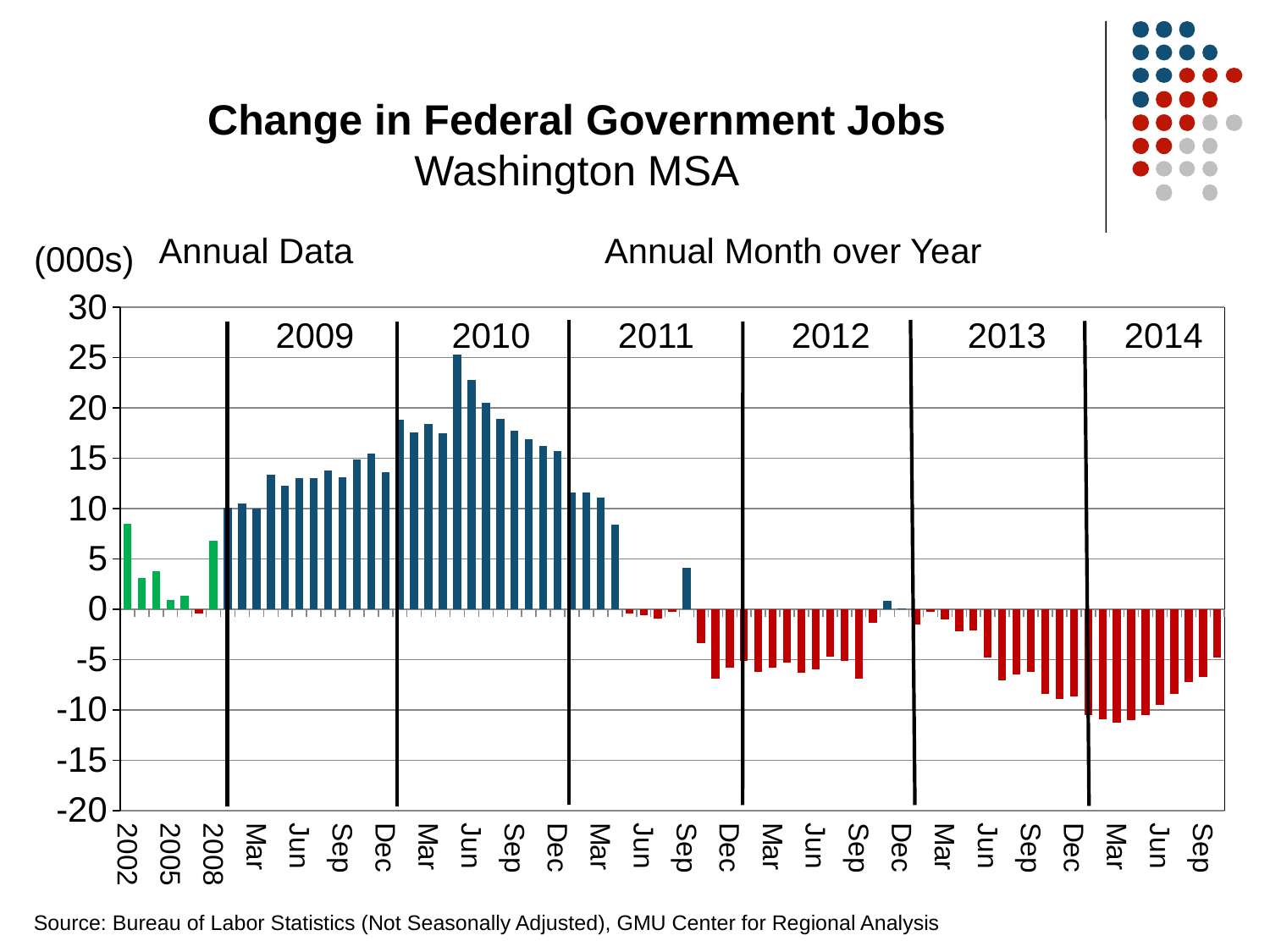
Which is larger, the value for Jun 2010 or the value for Mar 2009? Jun 2010 Is the value for Jun 2010 greater or less than 20? greater What kind of chart is shown on the slide? bar chart Do the values rise or fall from Mar 2014 to Sep 2014? rise What is the title of the chart? Change in Federal Government Jobs Is the value for Dec 2013 greater or less than -5? less In what units are the values on the chart expressed, according to the label above the y axis? (000s) Is the value for the 2002 annual bar greater or less than 5? greater Which is larger, the 2002 annual value or the 2005 annual value? 2002 In which month and year does the chart reach its highest value? May 2010 Do the values rise or fall from Jun 2010 to Dec 2010? fall